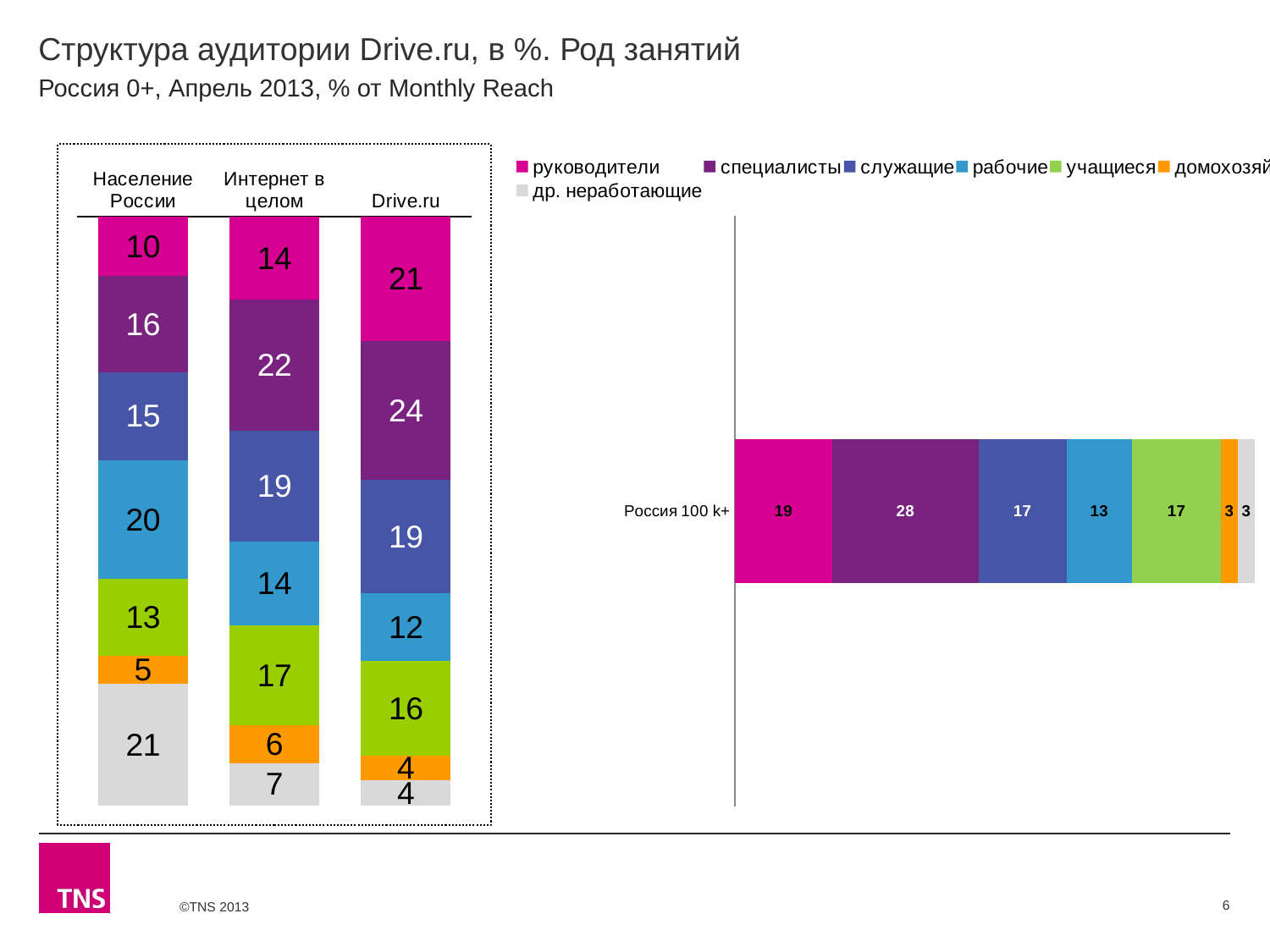
How many columns (categories) are shown in the left chart? 3 What kind of chart is the right chart? Stacked bar chart In the left chart, which is larger: рабочие for Население России or рабочие for Drive.ru? Население России In the right chart, what is the total of the Россия 100 k+ bar? 100 In the left chart, what is the difference between the руководители values for Drive.ru and Население России? 11 In the left chart, what is the value for служащие in the Интернет в целом column? 19 How many series does the legend list? 7 In the left chart, which column has the lowest value for др. неработающие? Drive.ru In the left chart, what is the value for др. неработающие in the Население России column? 21 In the left chart, which column has the highest value for руководители? Drive.ru In the left chart, what is the value for специалисты in the Drive.ru column? 24 In the right chart, what is the value for специалисты for Россия 100 k+? 28